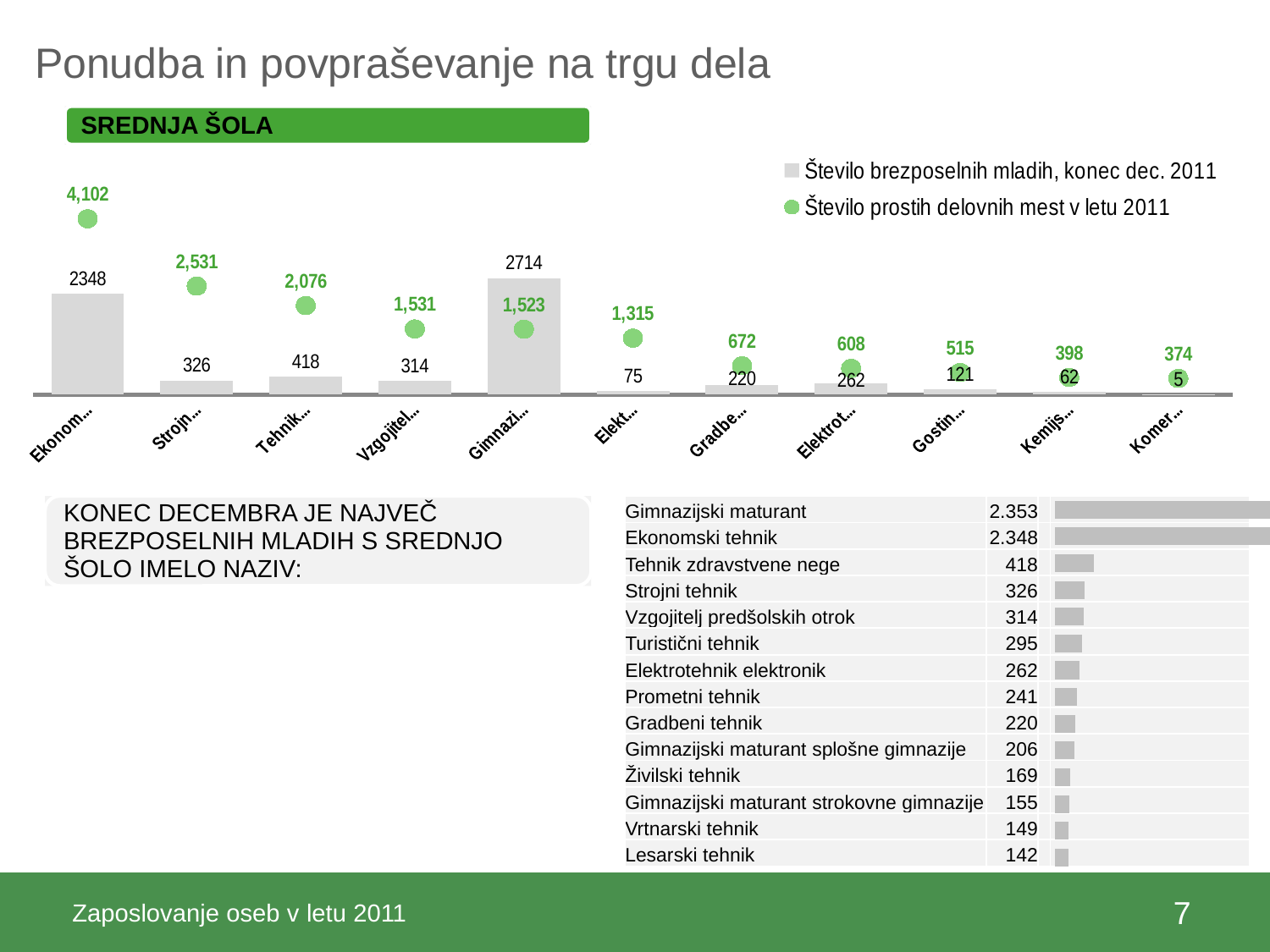
In the SREDNJA ŠOLA chart, which category has the lowest value of Število brezposelnih mladih, konec dec. 2011? Komer... In the SREDNJA ŠOLA chart, which category has the highest value of Število brezposelnih mladih, konec dec. 2011? Gimnazi... How many categories are shown on the x axis of the SREDNJA ŠOLA chart? 11 In the SREDNJA ŠOLA chart, what is the difference between the Število brezposelnih mladih values for 'Gimnazi...' and 'Ekonom...'? 366 In the SREDNJA ŠOLA chart, what is the value of Število prostih delovnih mest v letu 2011 for the category labelled 'Gostin...'? 515 In the SREDNJA ŠOLA chart, what is the value of Število prostih delovnih mest v letu 2011 for the category labelled 'Strojn...'? 2,531 In the SREDNJA ŠOLA chart, what is the difference between the Število prostih delovnih mest values for 'Gradbe...' and 'Elektrot...'? 64 In the SREDNJA ŠOLA chart, which has the larger Število brezposelnih mladih value: 'Tehnik...' or 'Strojn...'? Tehnik... How many series does the legend of the SREDNJA ŠOLA chart list? 2 In the SREDNJA ŠOLA chart, which category has the highest value of Število prostih delovnih mest v letu 2011? Ekonom... In the SREDNJA ŠOLA chart, what is the value of Število brezposelnih mladih, konec dec. 2011 for the category labelled 'Ekonom...'? 2348 In the SREDNJA ŠOLA chart, do the Število prostih delovnih mest v letu 2011 values generally rise or fall from left to right? fall